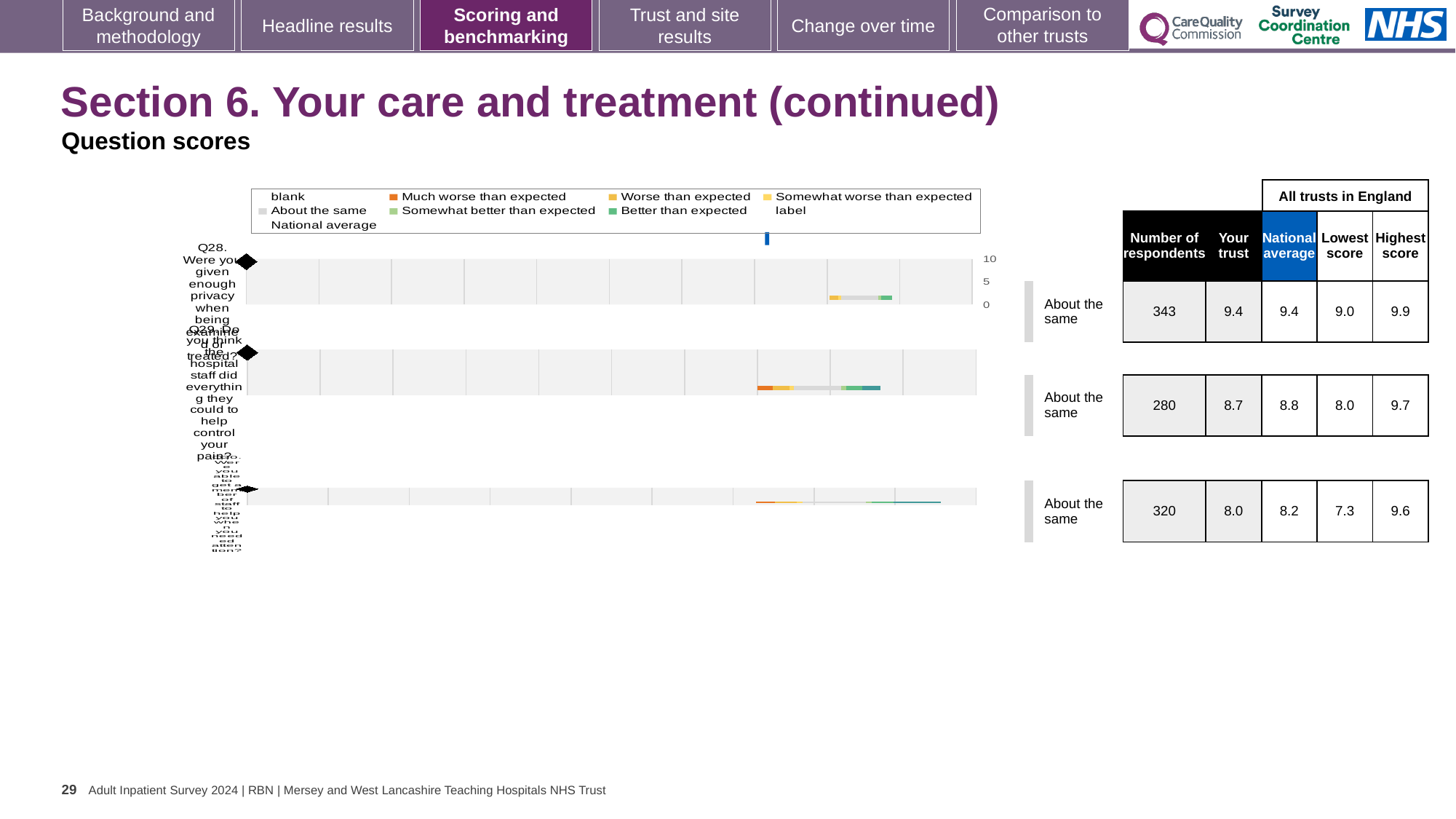
What benchmark category is shown for Q29? About the same How many questions are plotted on the chart? 3 What is the difference between the national average and the 'Your trust' score for the third question (Q30)? 0.2 Which question has the lowest 'Your trust' score? Q30 What kind of chart is used to show the question scores? Bar chart What is the lowest score among all trusts in England for the third question (Q30)? 7.3 What is the national average score for Q29 (Do you think the hospital staff did everything they could to help control your pain?)? 8.8 How many respondents answered Q28? 343 What is the highest score among all trusts in England for Q29? 9.7 Which question has the highest 'Your trust' score? Q28 Which has the larger 'Your trust' score, Q28 or Q29? Q28 What is the 'Your trust' score for Q28 (Were you given enough privacy when being examined or treated?)? 9.4